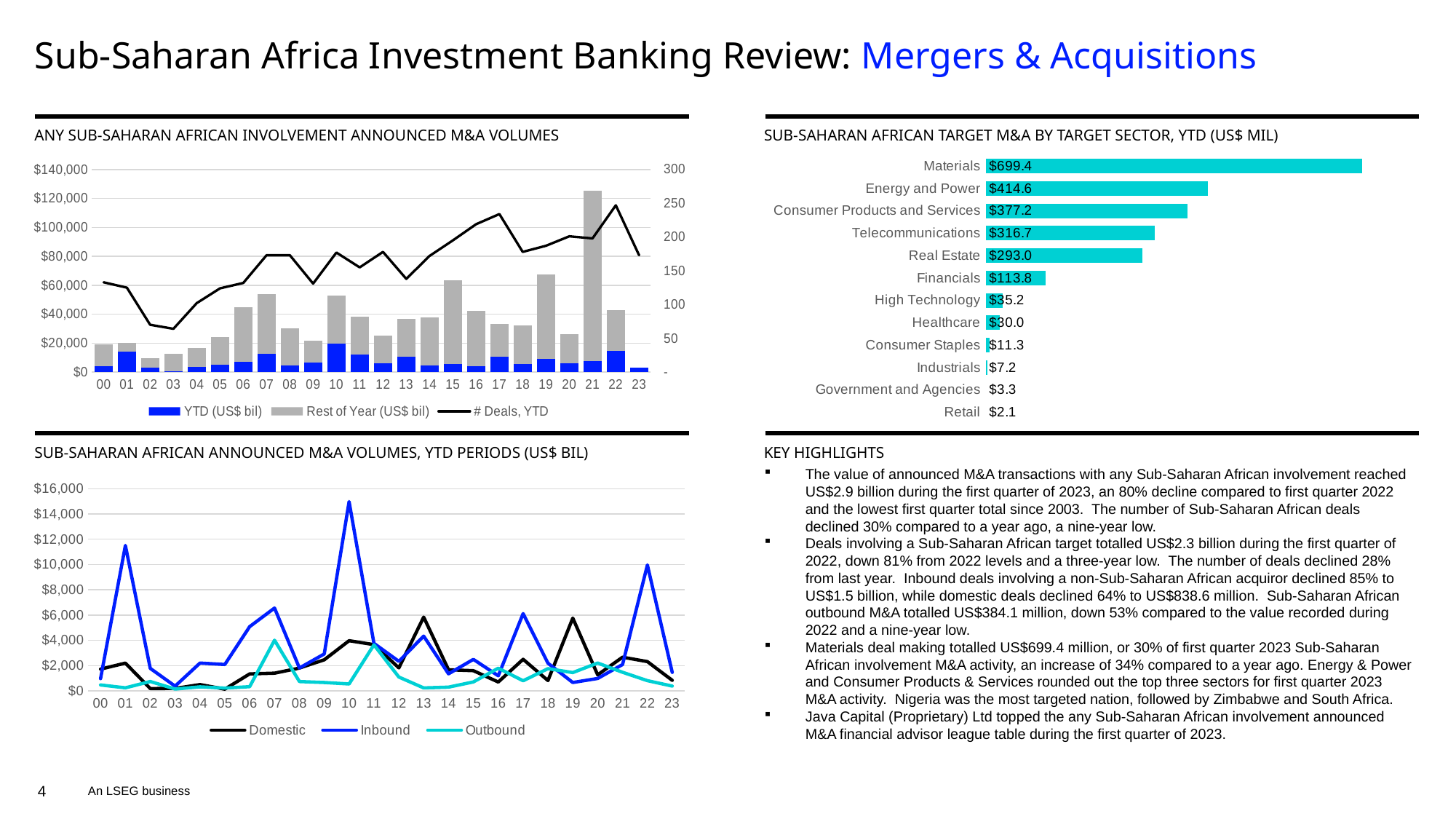
In the chart titled 'Any Sub-Saharan African Involvement Announced M&A Volumes', which year has the tallest stacked bar? 21 In the chart titled 'Sub-Saharan African Target M&A by Target Sector, YTD (US$ mil)', what is the difference between Materials and Energy and Power? $284.8 What kind of chart is the 'Sub-Saharan African Target M&A by Target Sector, YTD (US$ mil)' chart? Bar chart What are the three series listed in the legend of the chart titled 'Sub-Saharan African Announced M&A Volumes, YTD Periods (US$ bil)'? Domestic, Inbound, Outbound In the chart titled 'Any Sub-Saharan African Involvement Announced M&A Volumes', is the total stacked bar for 21 greater or less than $100,000? greater In the chart titled 'Sub-Saharan African Target M&A by Target Sector, YTD (US$ mil)', which is larger, Real Estate or Telecommunications? Telecommunications In the chart titled 'Sub-Saharan African Target M&A by Target Sector, YTD (US$ mil)', which sector has the lowest value? Retail How many series does the legend list in the chart titled 'Any Sub-Saharan African Involvement Announced M&A Volumes'? 3 In the chart titled 'Sub-Saharan African Target M&A by Target Sector, YTD (US$ mil)', what is the value for Telecommunications? $316.7 How many sectors are shown in the chart titled 'Sub-Saharan African Target M&A by Target Sector, YTD (US$ mil)'? 12 In the chart titled 'Sub-Saharan African Announced M&A Volumes, YTD Periods (US$ bil)', in which year does the Inbound line reach its highest point? 10 In the chart titled 'Sub-Saharan African Target M&A by Target Sector, YTD (US$ mil)', what is the value for Materials? $699.4